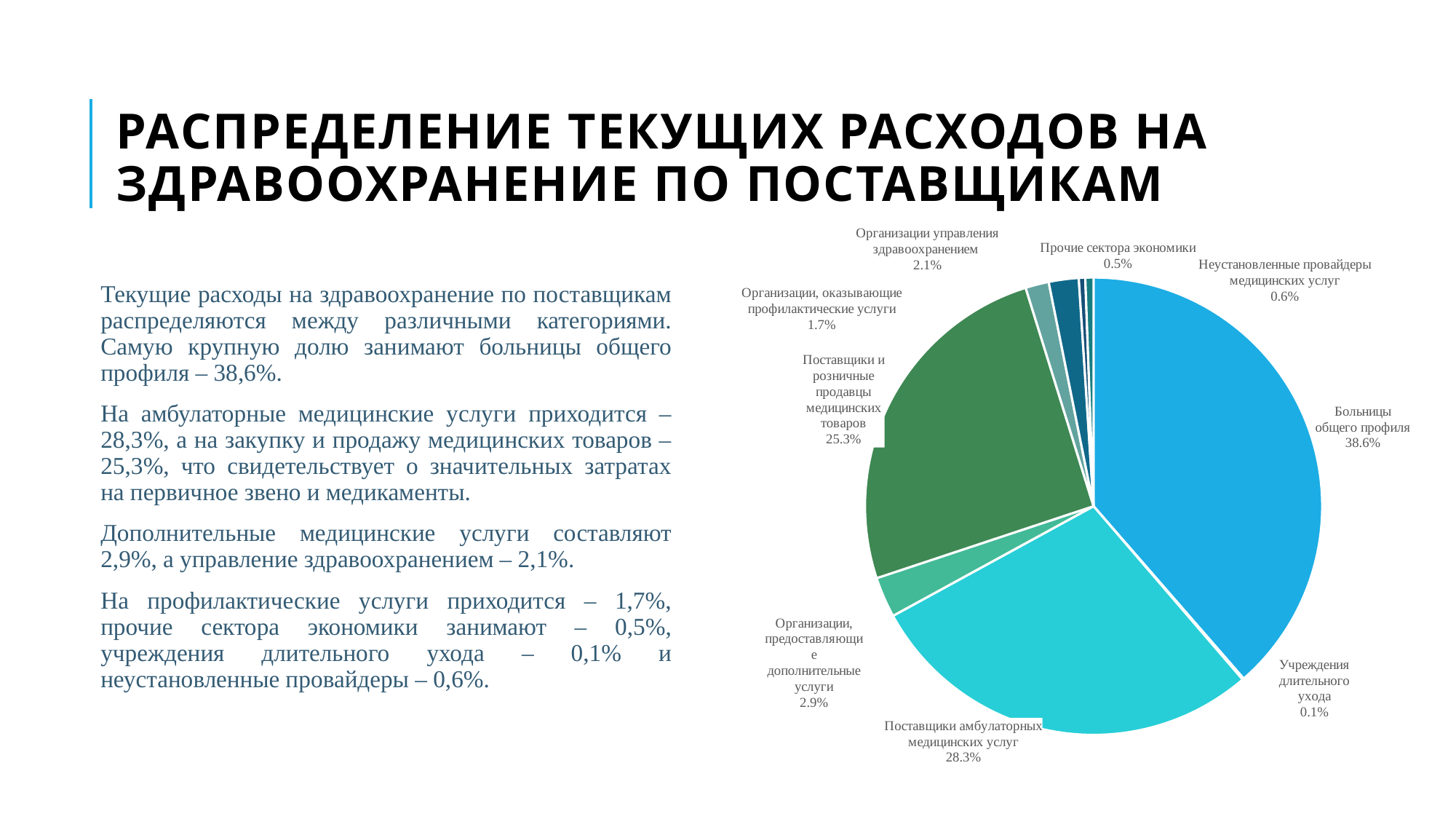
What is the difference between the shares of "Больницы общего профиля" and "Поставщики амбулаторных медицинских услуг"? 10.3% What kind of chart is shown on the slide? pie chart What is the value shown for "Поставщики амбулаторных медицинских услуг"? 28.3% Which category has the smallest slice of the pie? Учреждения длительного ухода What share of the pie does "Больницы общего профиля" have? 38.6% Which is larger: the share of "Организации, предоставляющие дополнительные услуги" or "Организации, оказывающие профилактические услуги"? Организации, предоставляющие дополнительные услуги How many slices does the pie chart have? 9 What is the value shown for "Неустановленные провайдеры медицинских услуг"? 0.6% What is the value shown for "Поставщики и розничные продавцы медицинских товаров"? 25.3% Which category has the largest slice of the pie? Больницы общего профиля What is the value shown for "Организации управления здравоохранением"? 2.1% What is the combined share of "Прочие сектора экономики" and "Неустановленные провайдеры медицинских услуг"? 1.1%